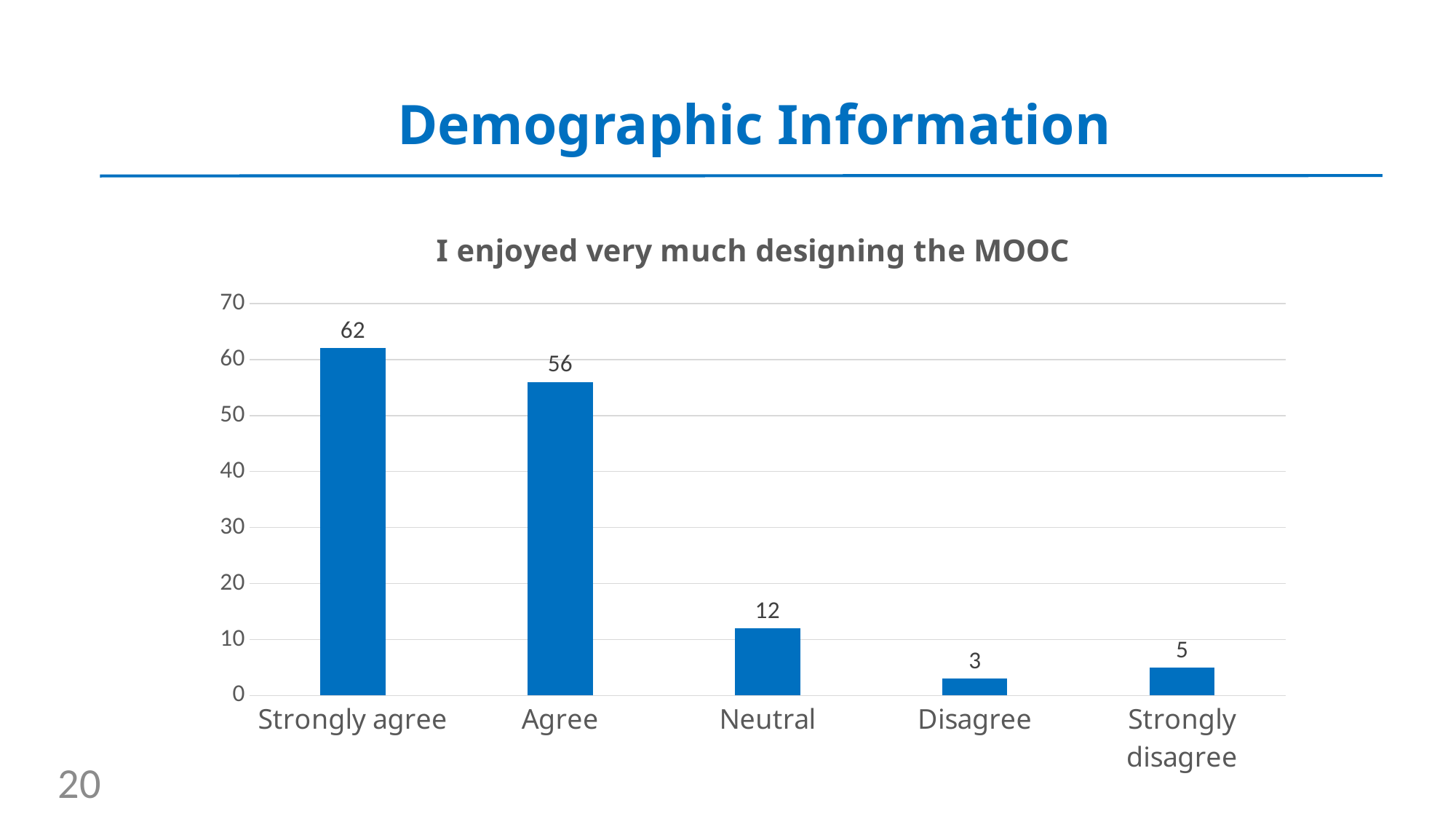
What is the value for Neutral? 12 What is the value for Agree? 56 What is the value for Strongly disagree? 5 How many categories are shown on the x axis? 5 Which is larger, the value for Neutral or the value for Strongly disagree? Neutral Which category has the lowest value? Disagree What is the difference between the values for Strongly agree and Agree? 6 What is the value for Disagree? 3 Which category has the highest value? Strongly agree What is the title of the chart? I enjoyed very much designing the MOOC What kind of chart is shown on the slide? Bar chart What is the value for Strongly agree? 62